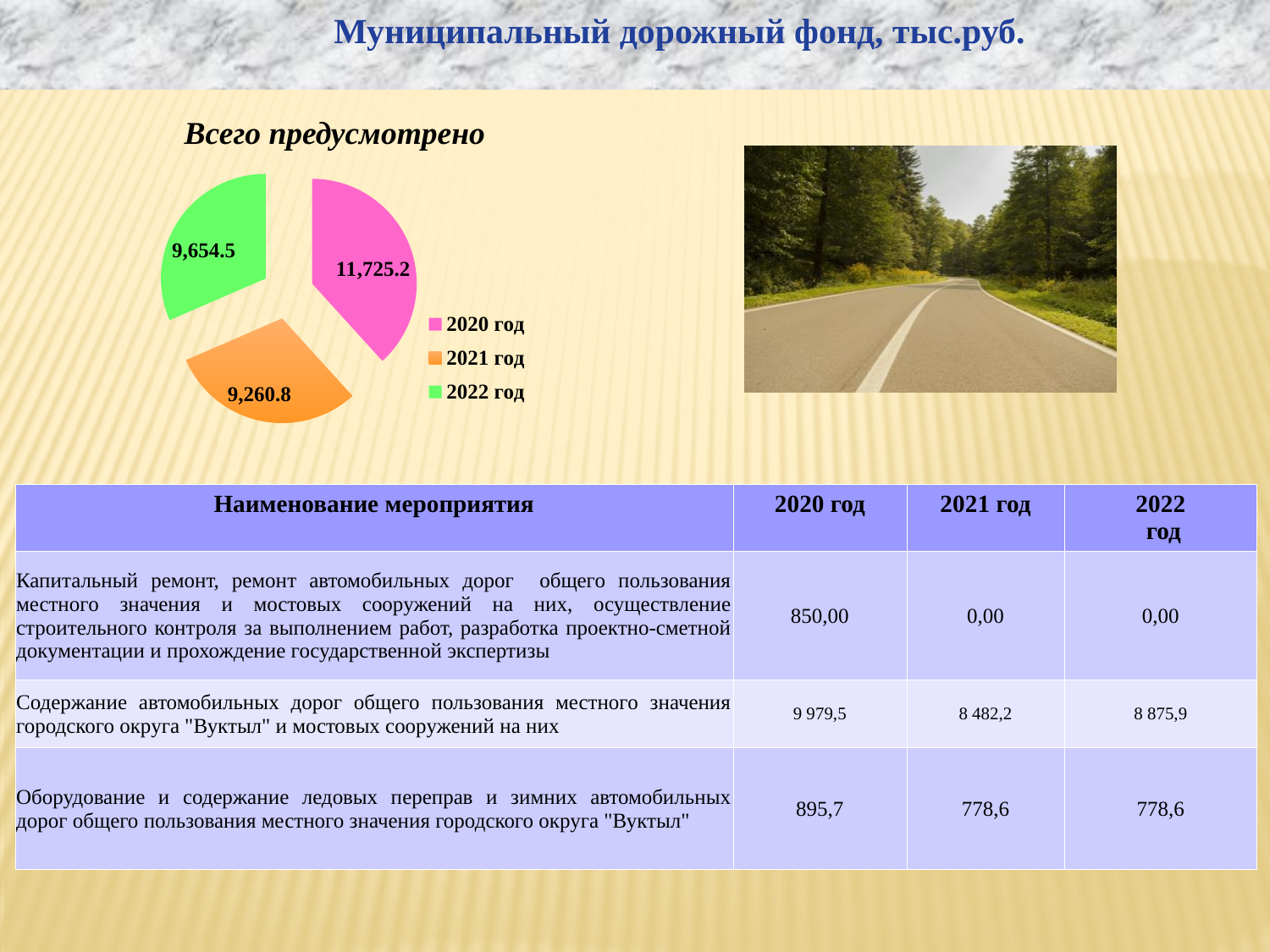
What is the value for 2021 год in the pie chart? 9,260.8 What is the total of all slices in the pie chart? 30,640.5 Which is larger in the pie chart, the value for 2020 год or the value for 2022 год? 2020 год Which year has the smallest slice in the pie chart? 2021 год What is the difference between the values for 2022 год and 2021 год in the pie chart? 393.7 What is the value for 2022 год in the pie chart? 9,654.5 What is the difference between the values for 2020 год and 2021 год in the pie chart? 2,464.4 Which colour represents 2022 год in the pie chart? green What type of chart is shown under the heading "Всего предусмотрено"? pie chart What is the value for 2020 год in the pie chart? 11,725.2 How many slices does the pie chart have? 3 Which year has the largest slice in the pie chart? 2020 год